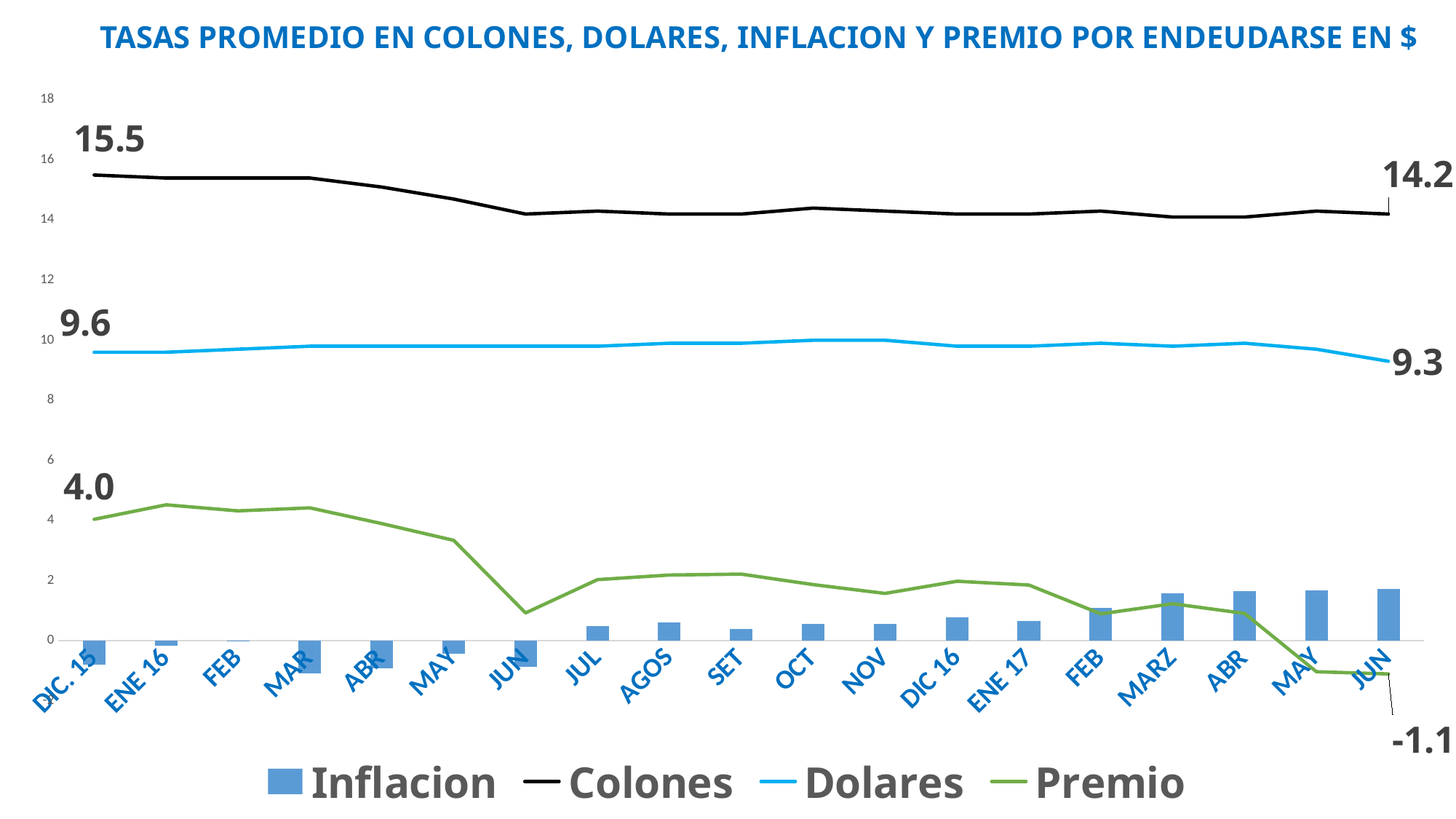
What is the value of the Dolares series at DIC. 15? 9.6 What is the difference between the Premio value at DIC. 15 and at the final JUN point? 5.1 Does the Premio series rise or fall overall from DIC. 15 to the final JUN? fall What is the value of the Colones series at the final JUN point? 14.2 What is the value of the Colones series at DIC. 15? 15.5 Is the Inflacion value for the final JUN greater or less than 1? greater What is the value of the Premio series at the final JUN point? -1.1 What is the value of the Premio series at DIC. 15? 4.0 How many series does the legend list? 4 By how much did the Colones series fall from DIC. 15 to the final JUN point? 1.3 How many months are shown along the x axis? 19 What is the value of the Dolares series at the final JUN point? 9.3